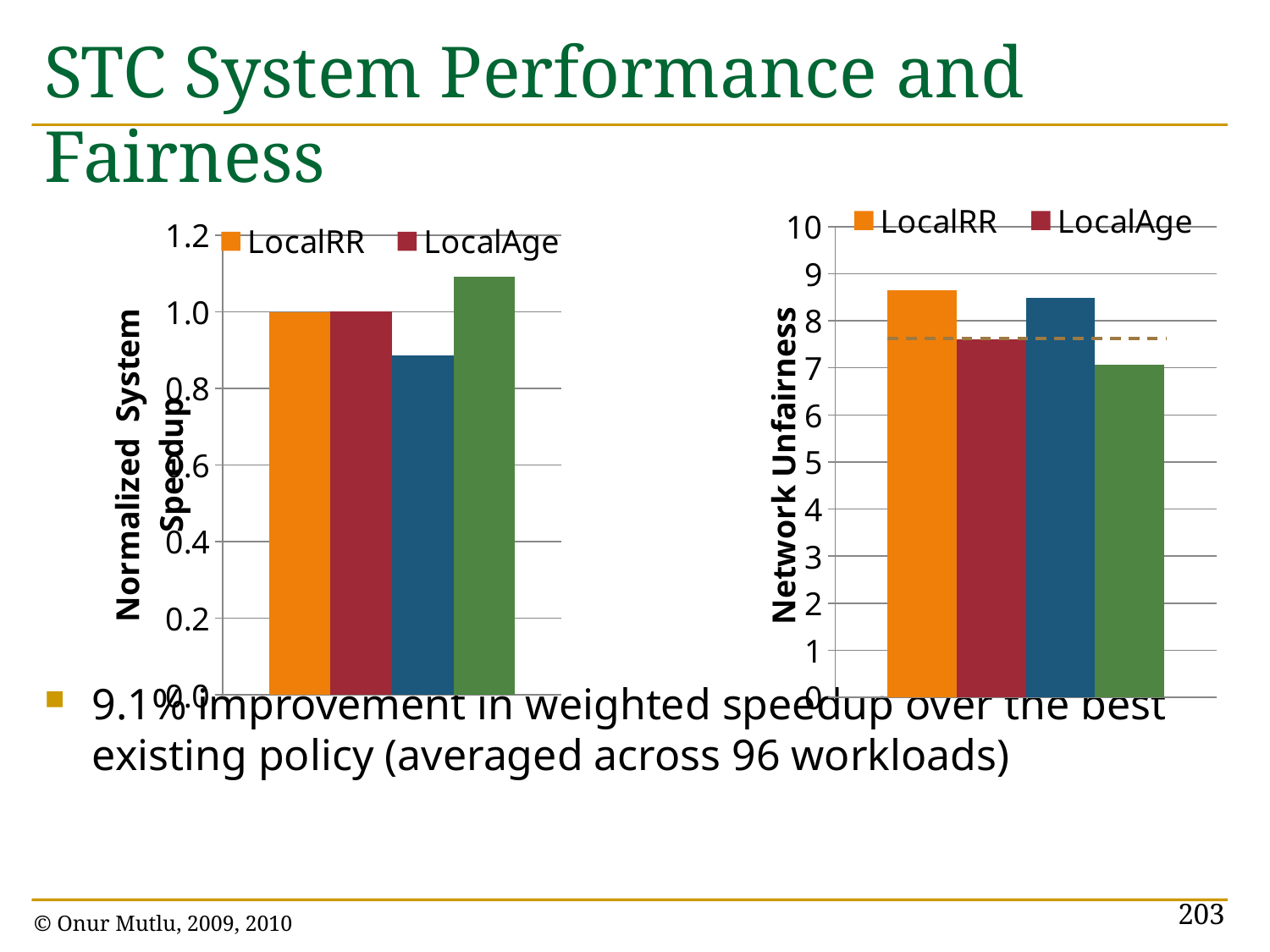
What is the y-axis title of the right chart? Network Unfairness In the left chart (Normalized System Speedup), what is the value for LocalRR? 1.0 In the left chart (Normalized System Speedup), is the value for LocalAge greater or less than 0.8? greater In the right chart (Network Unfairness), how many series does the legend list? 2 In the right chart (Network Unfairness), is the value for LocalRR greater or less than 9? less In the right chart (Network Unfairness), is the value for LocalAge greater or less than 8? less How many bars are plotted in the right chart (Network Unfairness)? 4 What kind of chart is the left chart (Normalized System Speedup)? bar chart What is the y-axis title of the left chart? Normalized System Speedup In the right chart (Network Unfairness), which is larger, LocalRR or LocalAge? LocalRR